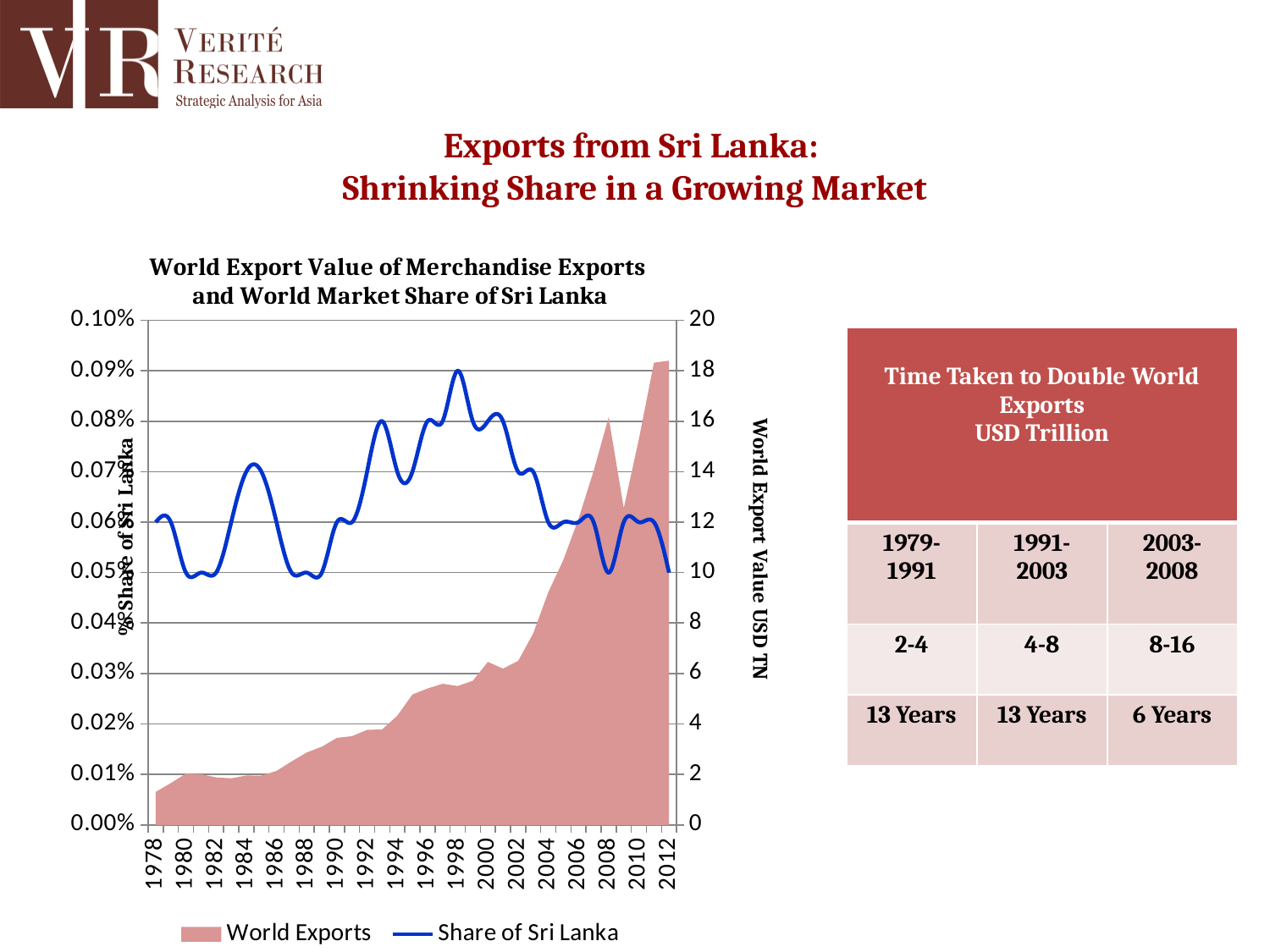
Is the value of World Exports in 2012 greater or less than 16 on the right axis? greater In which year does the World Exports series reach its highest value? 2012 In which year is the World Exports series at its lowest value? 1978 What kind of chart is shown on the slide? A combined area and line chart What are the two series named in the chart legend? World Exports and Share of Sri Lanka How many series does the chart legend list? 2 What is the title of the chart? World Export Value of Merchandise Exports and World Market Share of Sri Lanka In which year does the Share of Sri Lanka line reach its highest value? 1998 Is the Share of Sri Lanka in 2012 greater or less than 0.06%? less Is the value of World Exports in 1978 greater or less than 2 on the right axis? less Which is larger: the Share of Sri Lanka in 1998 or in 2012? 1998